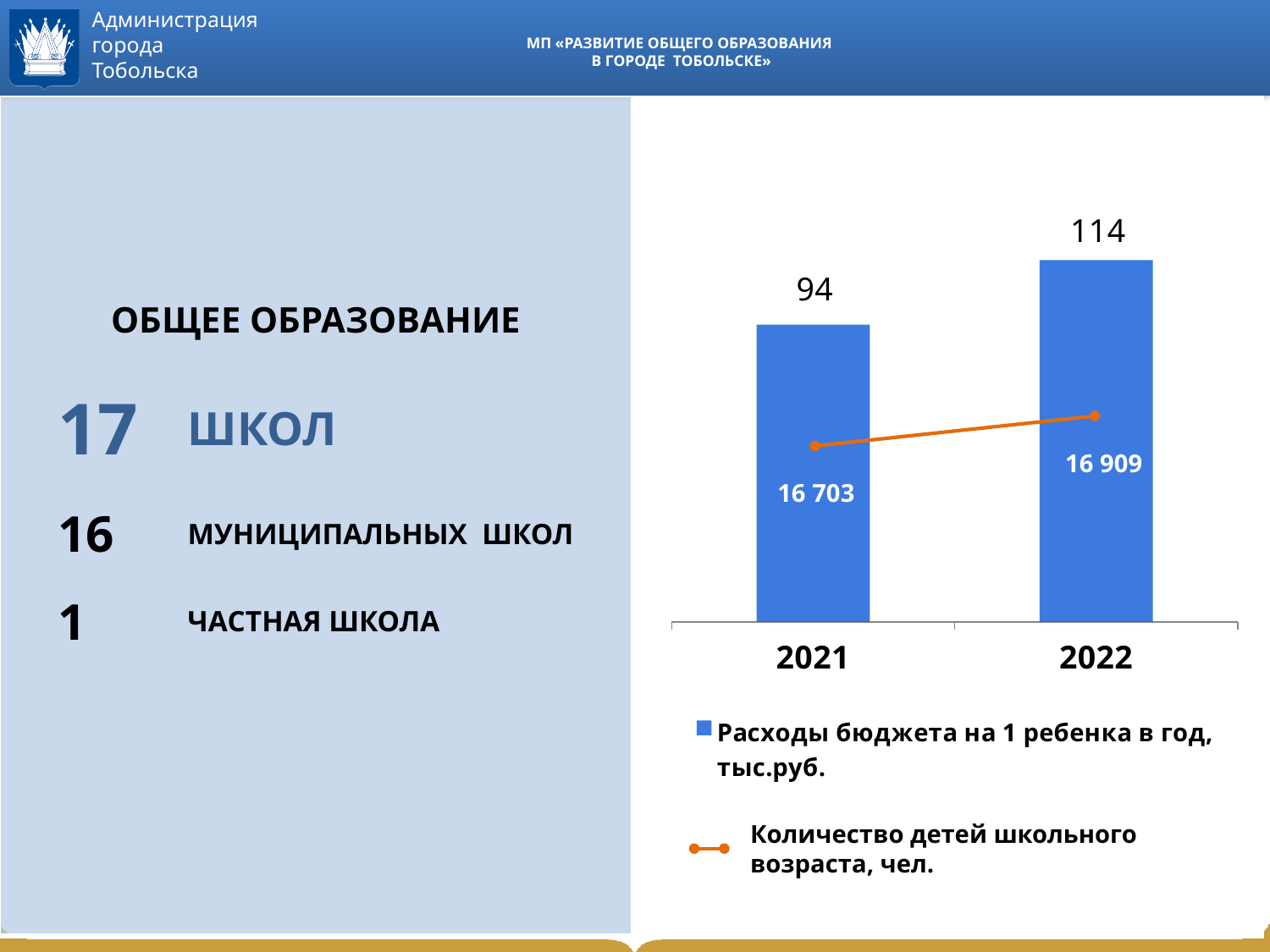
How many years are shown on the x axis of the chart? 2 What is the value of budget expenditure per child per year (Расходы бюджета на 1 ребенка в год, тыс.руб.) for 2021? 94 What is the value of budget expenditure per child per year (Расходы бюджета на 1 ребенка в год, тыс.руб.) for 2022? 114 What is the difference in the number of school-age children between 2022 and 2021? 206 Does the budget expenditure per child rise or fall from 2021 to 2022? rise What is the number of school-age children (Количество детей школьного возраста, чел.) in 2021? 16 703 Which year has the lower number of school-age children? 2021 What is the number of school-age children (Количество детей школьного возраста, чел.) in 2022? 16 909 How many series does the chart legend list? 2 Which year has the higher budget expenditure per child? 2022 By how much did budget expenditure per child increase from 2021 to 2022? 20 Is the number of school-age children larger in 2021 or in 2022? 2022